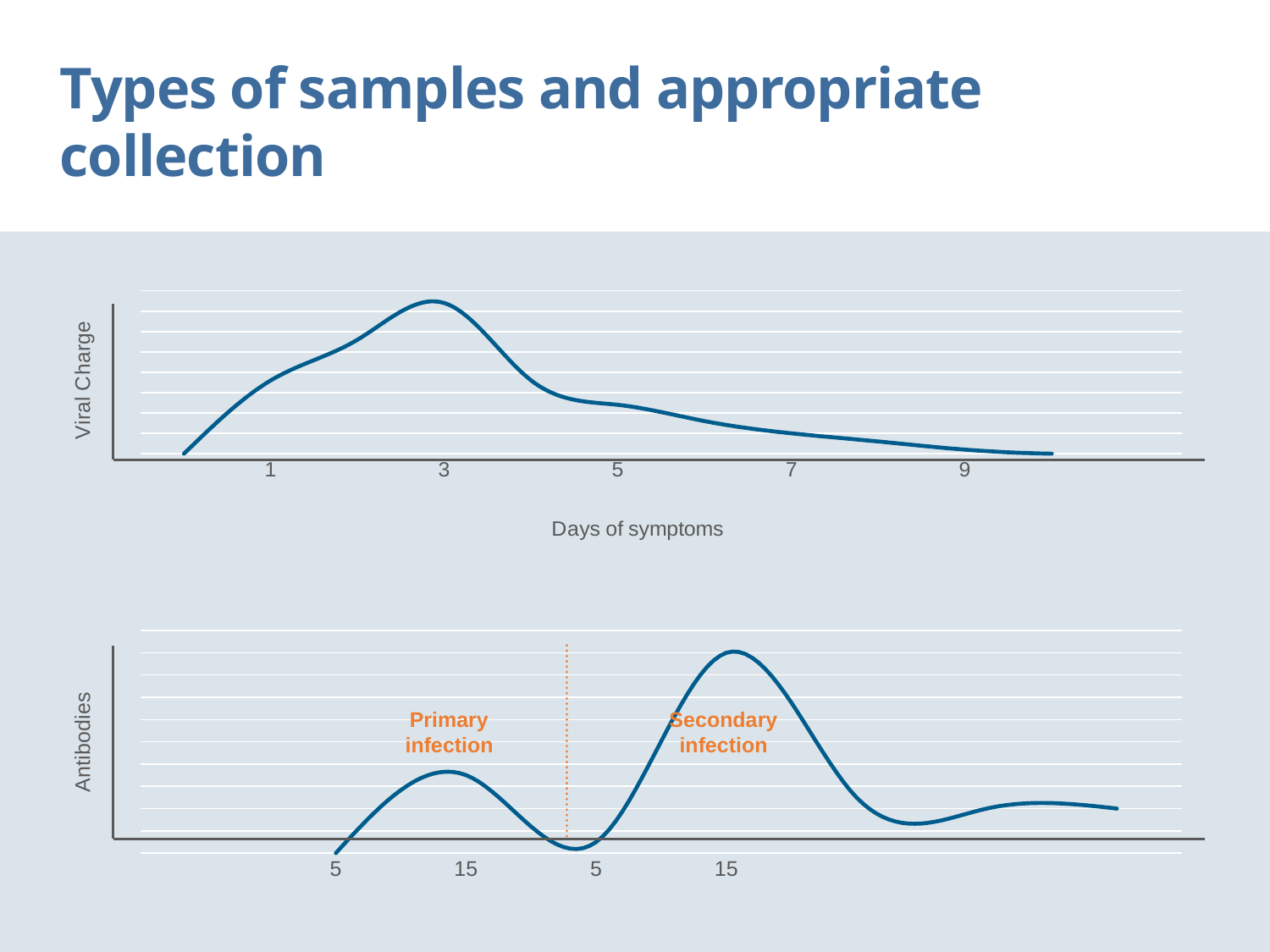
In the top chart, does the viral charge rise or fall between day 1 and day 3? rise In the bottom chart, which infection produces the higher antibody peak, the primary infection or the secondary infection? Secondary infection What kind of chart is the bottom chart on the slide (Antibodies)? line chart In the bottom chart, how many infection phases are labelled on the curve? 2 In the top chart, is the viral charge higher at day 1 or at day 7? day 1 In the top chart, how many tick labels are shown on the x axis? 5 In the top chart, what is the label of the x axis? Days of symptoms In the top chart, what is the label of the y axis? Viral Charge In the top chart, at which labelled day of symptoms does the viral charge reach its peak? 3 In the bottom chart, how many lines (series) are plotted? 1 In the top chart, does the viral charge rise or fall between day 3 and day 9? fall What kind of chart is the top chart on the slide (Viral Charge)? line chart